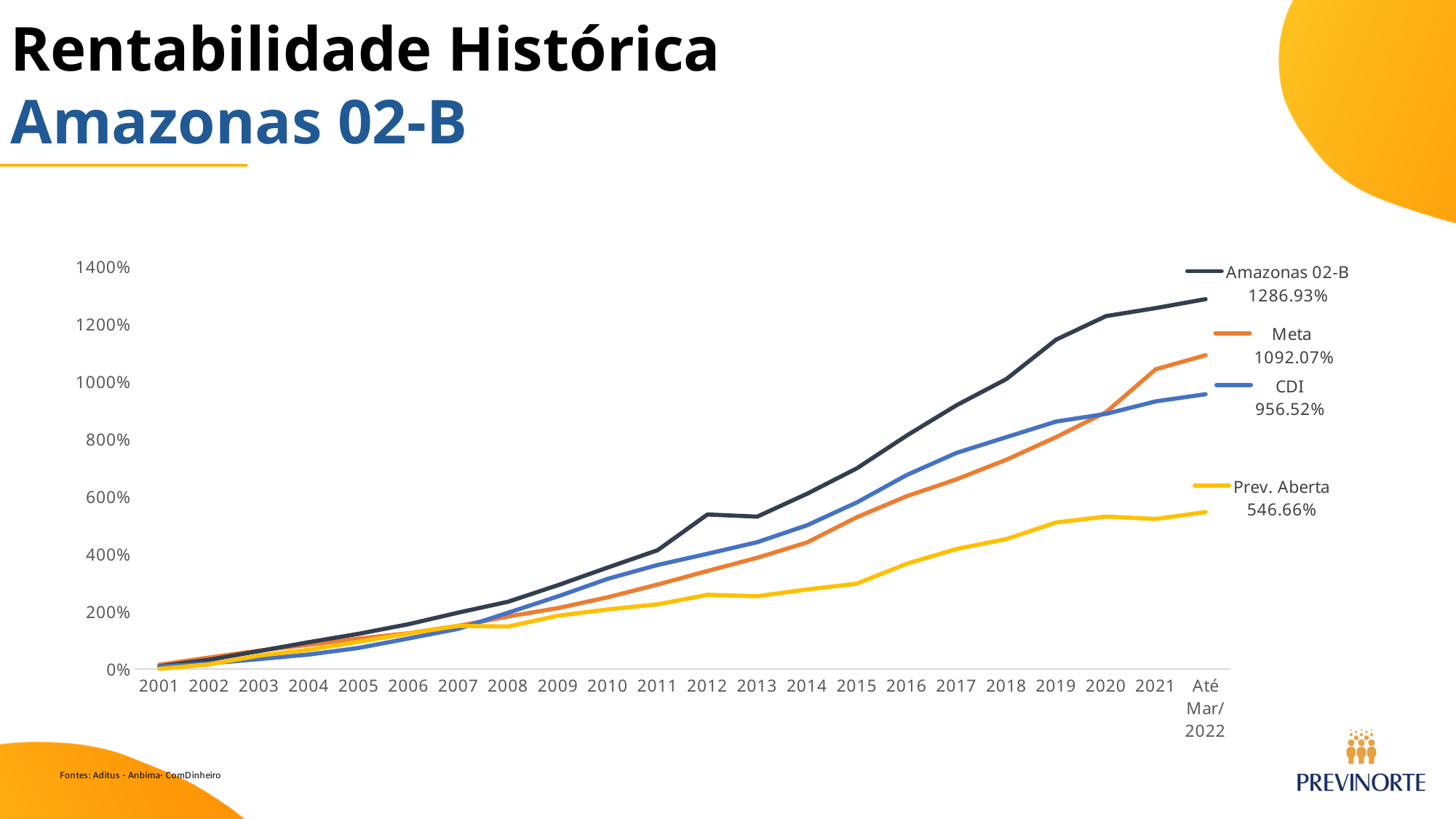
What is the final value shown for the CDI series? 956.52% Is the value for Prev. Aberta in 2015 greater or less than 400%? less How many series does the legend list? 4 What is the final value shown for the Amazonas 02-B series? 1286.93% What is the final value shown for the Meta series? 1092.07% Which series has the lowest value at the end of the period (Até Mar/2022)? Prev. Aberta What kind of chart is shown on the slide? Line chart What is the final value shown for the Prev. Aberta series? 546.66% Do the values of the Amazonas 02-B series generally rise or fall from 2001 to Até Mar/2022? Rise Which series has the highest value at the end of the period (Até Mar/2022)? Amazonas 02-B Which has a larger final value, Meta or CDI? Meta What is the difference between the final values of Amazonas 02-B and Meta? 194.86%